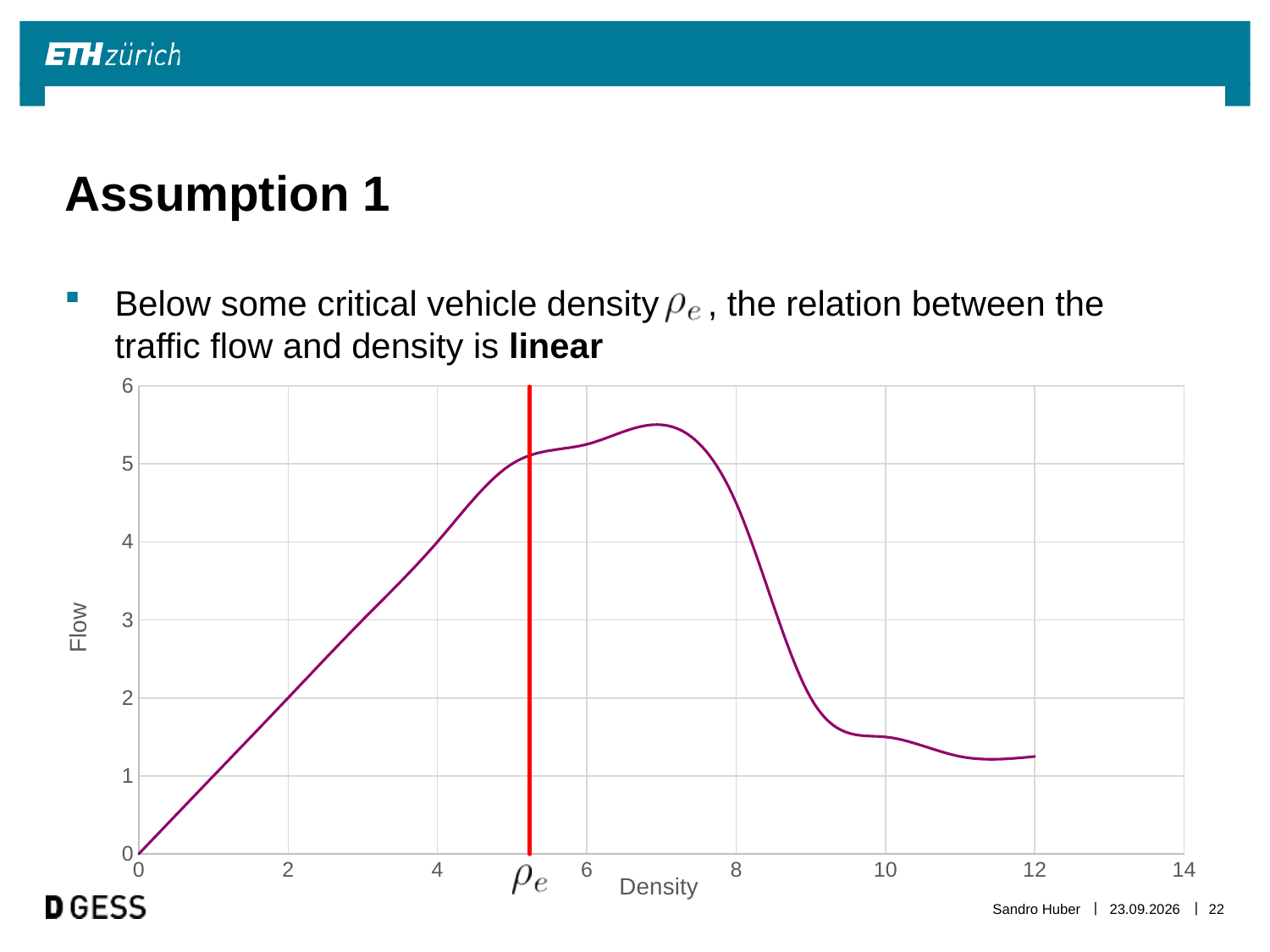
Is the flow at density 8 greater or less than 4? greater Is the flow at density 12 greater or less than 2? less What is the highest tick value shown on the Density axis? 14 What is the label of the y axis of the chart? Flow What kind of chart is shown on the slide? line chart Does the flow rise or fall as density increases from 8 to 10? fall What is the flow value at density 0? 0 Does the flow rise or fall as density increases from 0 to 5? rise What is the label of the x axis of the chart? Density Is the flow at density 7 greater or less than 5? greater